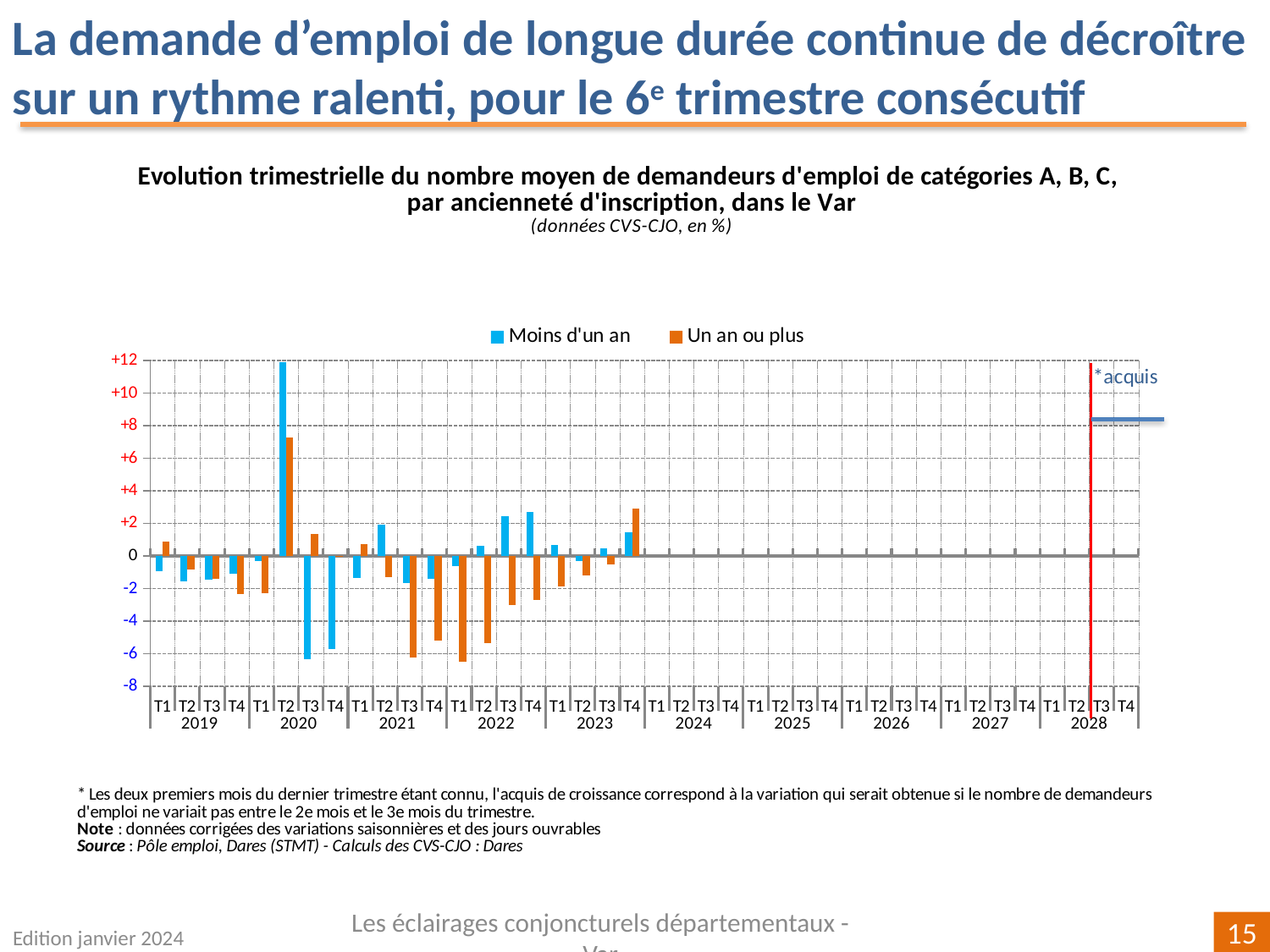
In which quarter does the 'Un an ou plus' series reach its highest value? T2 2020 In which quarter does the 'Moins d'un an' series reach its highest value? T2 2020 Is the value for 'Moins d'un an' in T2 2020 greater or less than +10? greater In which quarter does the 'Moins d'un an' series reach its lowest value? T3 2020 How many years are labelled along the x axis? 10 Is the value for 'Un an ou plus' in T3 2021 greater or less than -4? less In T4 2023, which series has the larger value, 'Moins d'un an' or 'Un an ou plus'? Un an ou plus How many series does the legend list? 2 Which colour represents the series 'Un an ou plus'? Orange Is the value for 'Moins d'un an' in T3 2020 greater or less than -4? less What kind of chart is shown on the slide? Bar chart What are the two series named in the legend? Moins d'un an; Un an ou plus